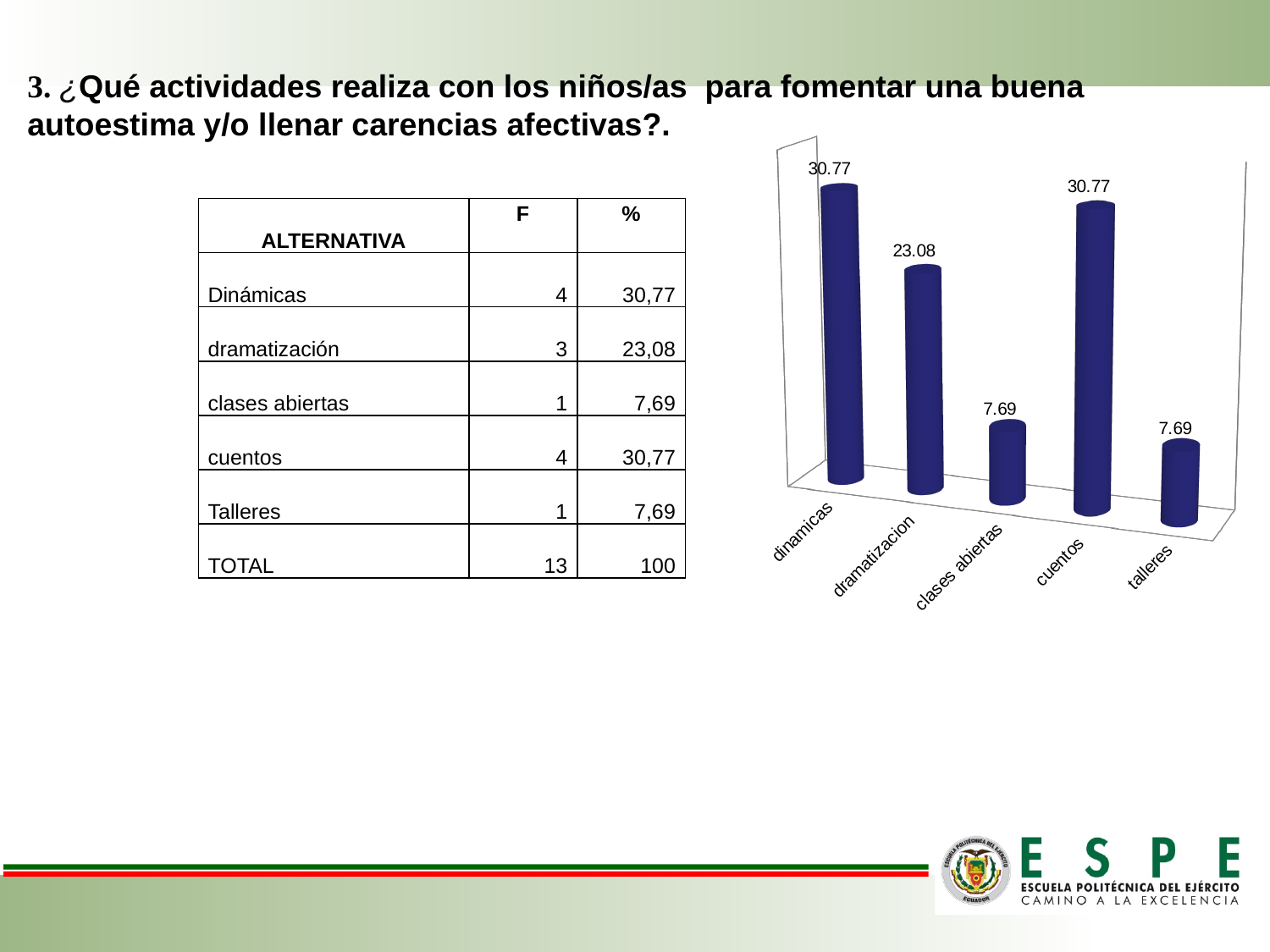
How many categories are shown in the chart? 5 What is the difference between the values for dramatizacion and clases abiertas? 15.39 What is the value shown for clases abiertas in the chart? 7.69 What kind of chart is shown on the slide? bar chart Which has a larger value, dramatizacion or talleres? dramatizacion What is the lowest value labelled on any bar in the chart? 7.69 What is the value shown for talleres in the chart? 7.69 What is the value shown for dramatizacion in the chart? 23.08 What is the highest value labelled on any bar in the chart? 30.77 What is the value shown for dinamicas in the chart? 30.77 What is the value shown for cuentos in the chart? 30.77 What is the difference between the values for dinamicas and dramatizacion? 7.69